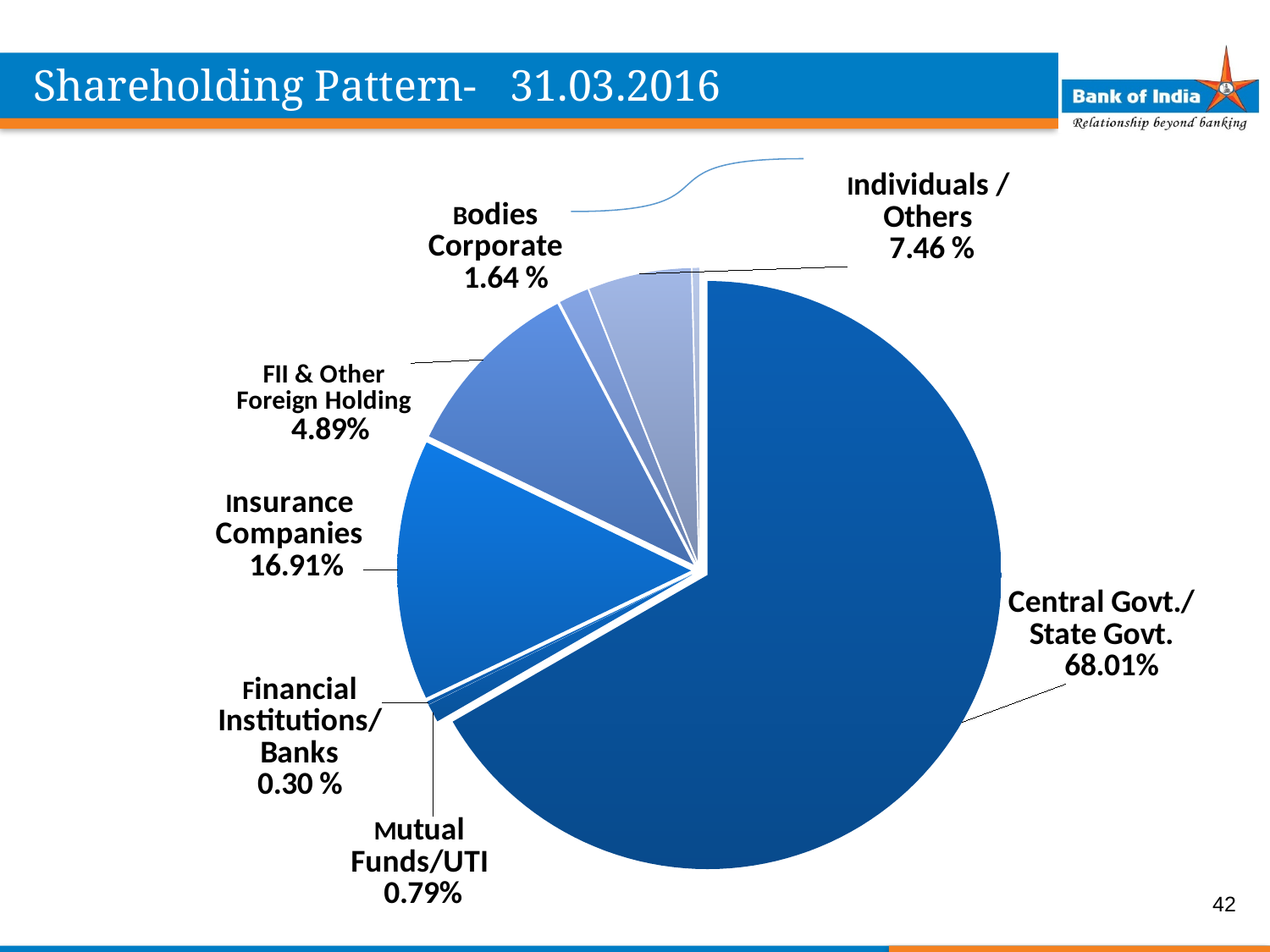
What share of shareholding is held by Insurance Companies? 16.91% What share of shareholding is held by FII & Other Foreign Holding? 4.89% What is the difference between the shares of Insurance Companies and Individuals / Others? 9.45% What share of shareholding is held by Individuals / Others? 7.46 % What share of shareholding is held by Financial Institutions/Banks? 0.30 % What type of chart is shown on the slide? pie chart How many categories are shown in the pie chart? 7 What share of shareholding is held by Central Govt./State Govt.? 68.01% Which category holds the smallest share of the pie? Financial Institutions/Banks Which is larger, the share of Bodies Corporate or the share of Mutual Funds/UTI? Bodies Corporate What share of shareholding is held by Mutual Funds/UTI? 0.79% Which category holds the largest share of the pie? Central Govt./State Govt.